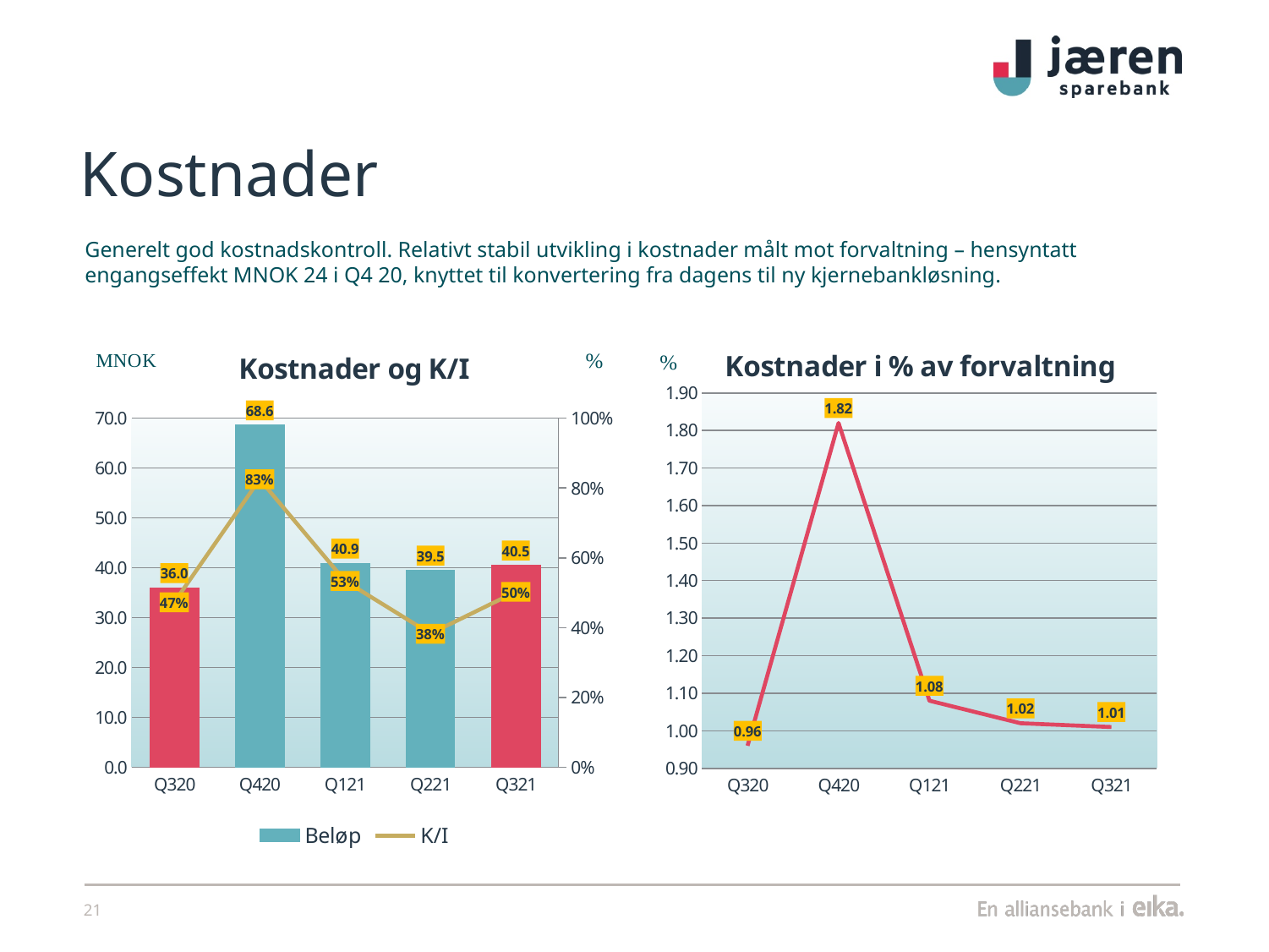
In the 'Kostnader i % av forvaltning' chart, how many quarters are plotted? 5 In the 'Kostnader i % av forvaltning' chart, which quarter has the lowest value? Q320 What kind of chart is 'Kostnader i % av forvaltning'? Line chart In the 'Kostnader og K/I' chart, which quarter has the lowest K/I? Q221 In the 'Kostnader i % av forvaltning' chart, what is the value for Q420? 1.82 In the 'Kostnader og K/I' chart, what is the K/I value for Q221? 38% In the 'Kostnader i % av forvaltning' chart, what is the difference between the Q121 and Q321 values? 0.07 In the 'Kostnader og K/I' chart, which quarter has the highest Beløp? Q420 In the 'Kostnader og K/I' chart, what is the difference in Beløp between Q420 and Q320? 32.6 In the 'Kostnader og K/I' chart, what is the Beløp value for Q420? 68.6 In the 'Kostnader og K/I' chart, is the Beløp for Q121 or Q221 larger? Q121 In the 'Kostnader og K/I' chart, how many series does the legend list? 2